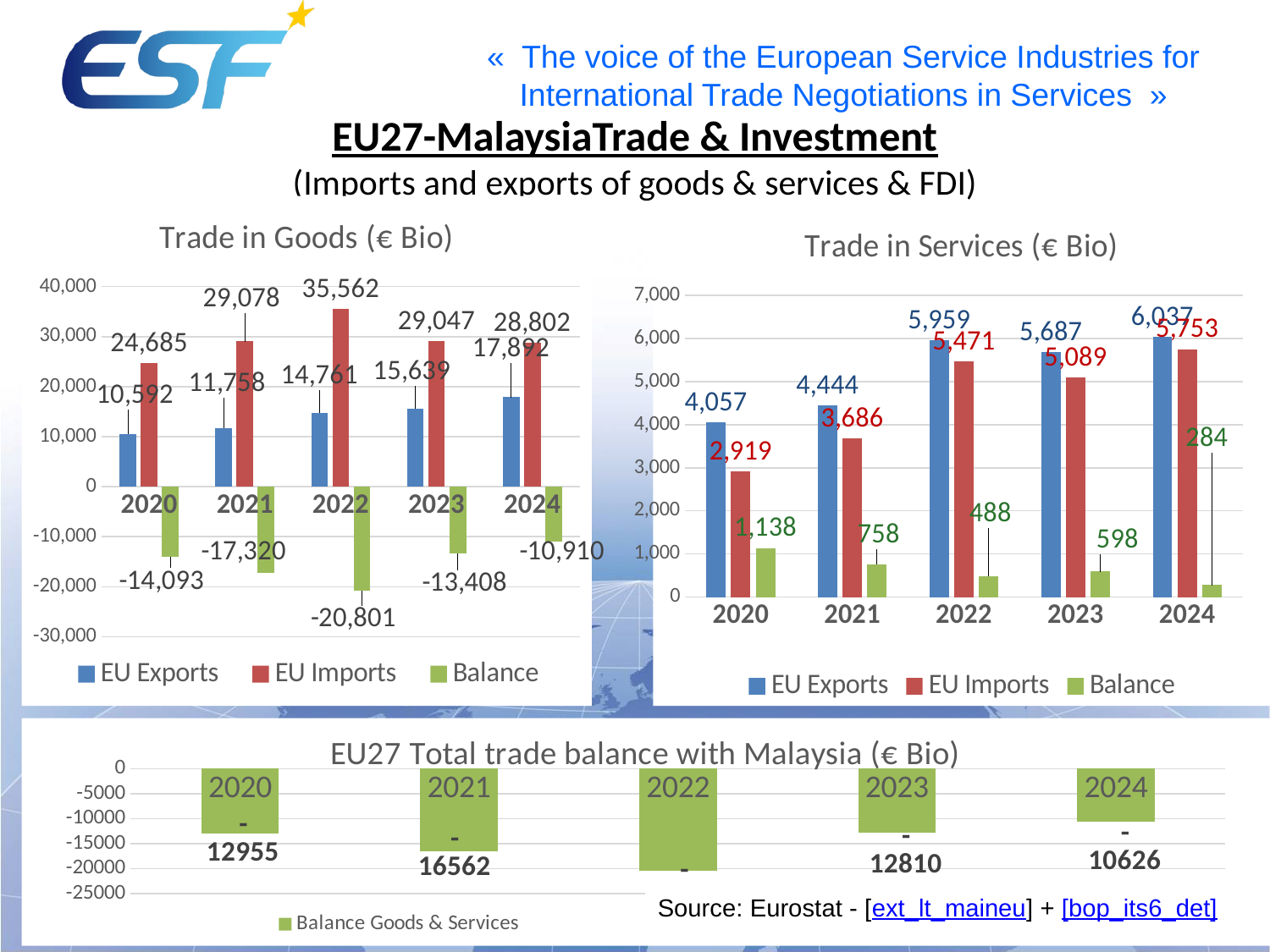
In the Trade in Goods chart, what is the difference between EU Imports and EU Exports in 2024? 10,910 What type of chart is the Trade in Goods chart? Bar chart In the EU27 Total trade balance with Malaysia chart, what is the value for 2024? -10626 In the Trade in Services chart, how many series does the legend list? 3 In the Trade in Goods chart, which year has the lowest Balance value? 2022 In the Trade in Goods chart, what is the value of EU Exports in 2020? 10,592 In the Trade in Goods chart, what is the value of EU Imports in 2022? 35,562 In the Trade in Services chart, what is the value of EU Imports in 2021? 3,686 In the EU27 Total trade balance with Malaysia chart, how many years are shown? 5 In the Trade in Services chart, what is the Balance value for 2024? 284 In the Trade in Services chart, is the value of EU Exports in 2020 greater or less than 4,000? greater In the Trade in Services chart, which year has the highest EU Exports value? 2024